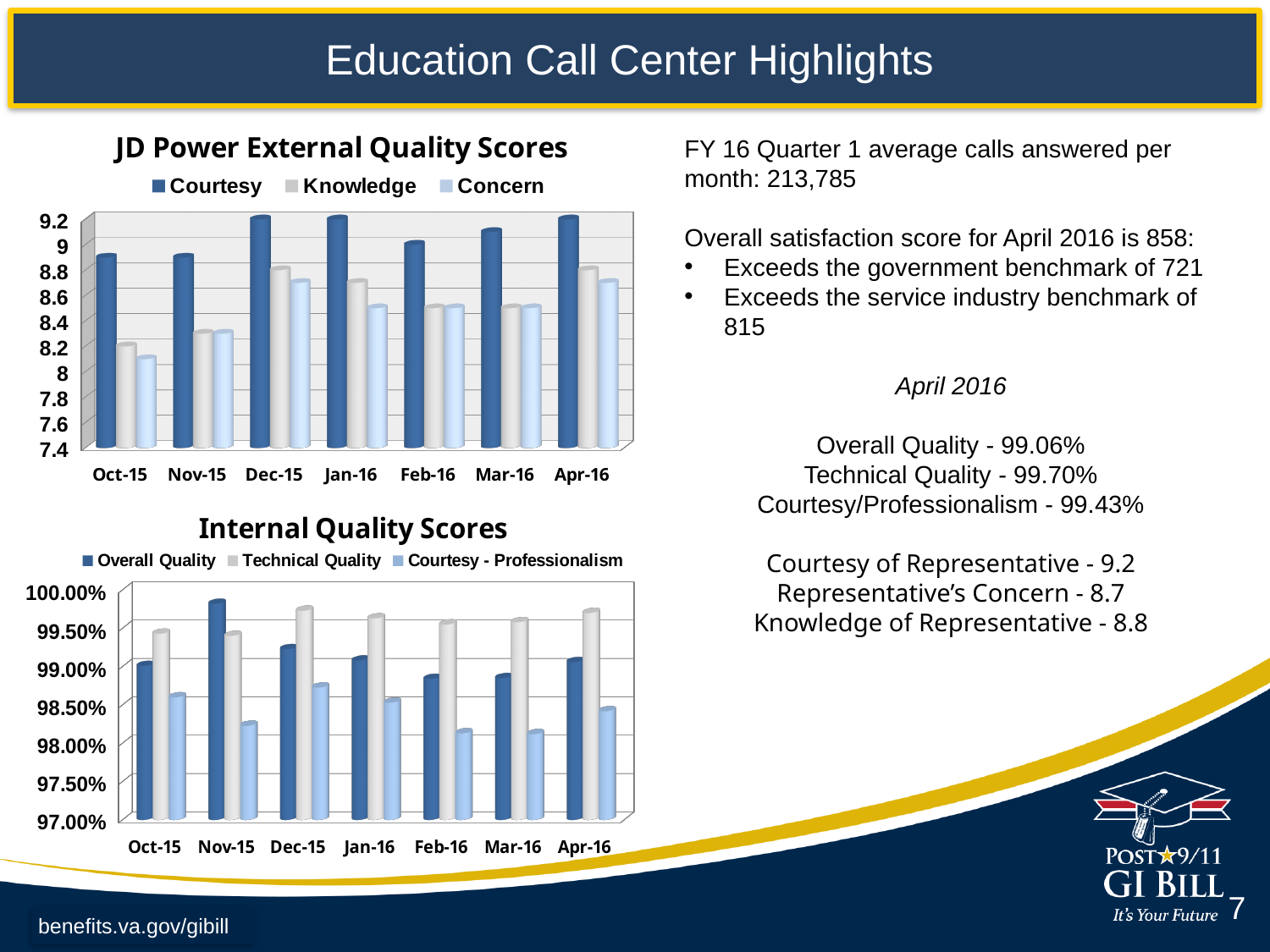
What are the three legend entries of the "Internal Quality Scores" chart? Overall Quality, Technical Quality, Courtesy - Professionalism In the "JD Power External Quality Scores" chart, which is larger for Oct-15, Courtesy or Knowledge? Courtesy How many months are shown on the x axis of the "JD Power External Quality Scores" chart? 7 What kind of chart is the "JD Power External Quality Scores" chart? bar chart How many series does the legend of the "JD Power External Quality Scores" chart list? 3 In the "Internal Quality Scores" chart, which is larger for Nov-15, Overall Quality or Technical Quality? Overall Quality What kind of chart is the "Internal Quality Scores" chart? bar chart In the "JD Power External Quality Scores" chart, does the Knowledge series rise or fall from Oct-15 to Dec-15? rise In the "JD Power External Quality Scores" chart, is the Concern value for Oct-15 greater or less than 8.4? less In the "JD Power External Quality Scores" chart, is the Courtesy value for Dec-15 greater or less than 9? greater In the "Internal Quality Scores" chart, is the Courtesy - Professionalism value for Nov-15 greater or less than 98.50%? less In the "Internal Quality Scores" chart, which month has the highest Overall Quality value? Nov-15